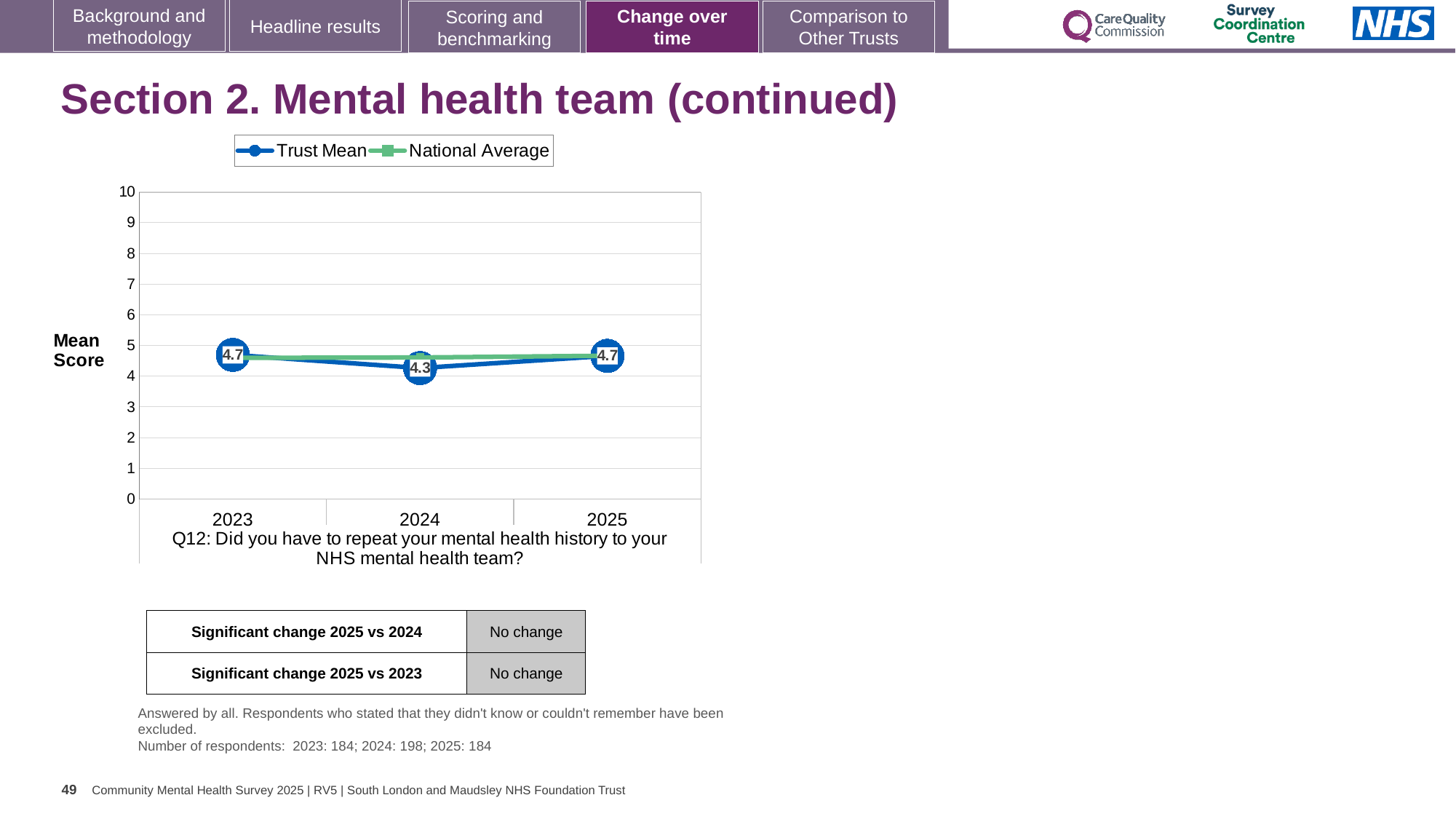
What is the label on the y axis of the chart? Mean Score Is the Trust Mean value for 2024 greater or less than 5? less What is the difference between the Trust Mean in 2023 and in 2024? 0.4 What kind of chart is shown on the slide? Line chart Is the National Average value for 2023 greater or less than 5? less What is the Trust Mean value for 2024? 4.3 Which is larger, the Trust Mean for 2024 or for 2025? 2025 In which year is the Trust Mean lowest? 2024 How many years are plotted on the x axis? 3 What is the Trust Mean value for 2025? 4.7 What is the Trust Mean value for 2023? 4.7 How many series does the legend list? 2